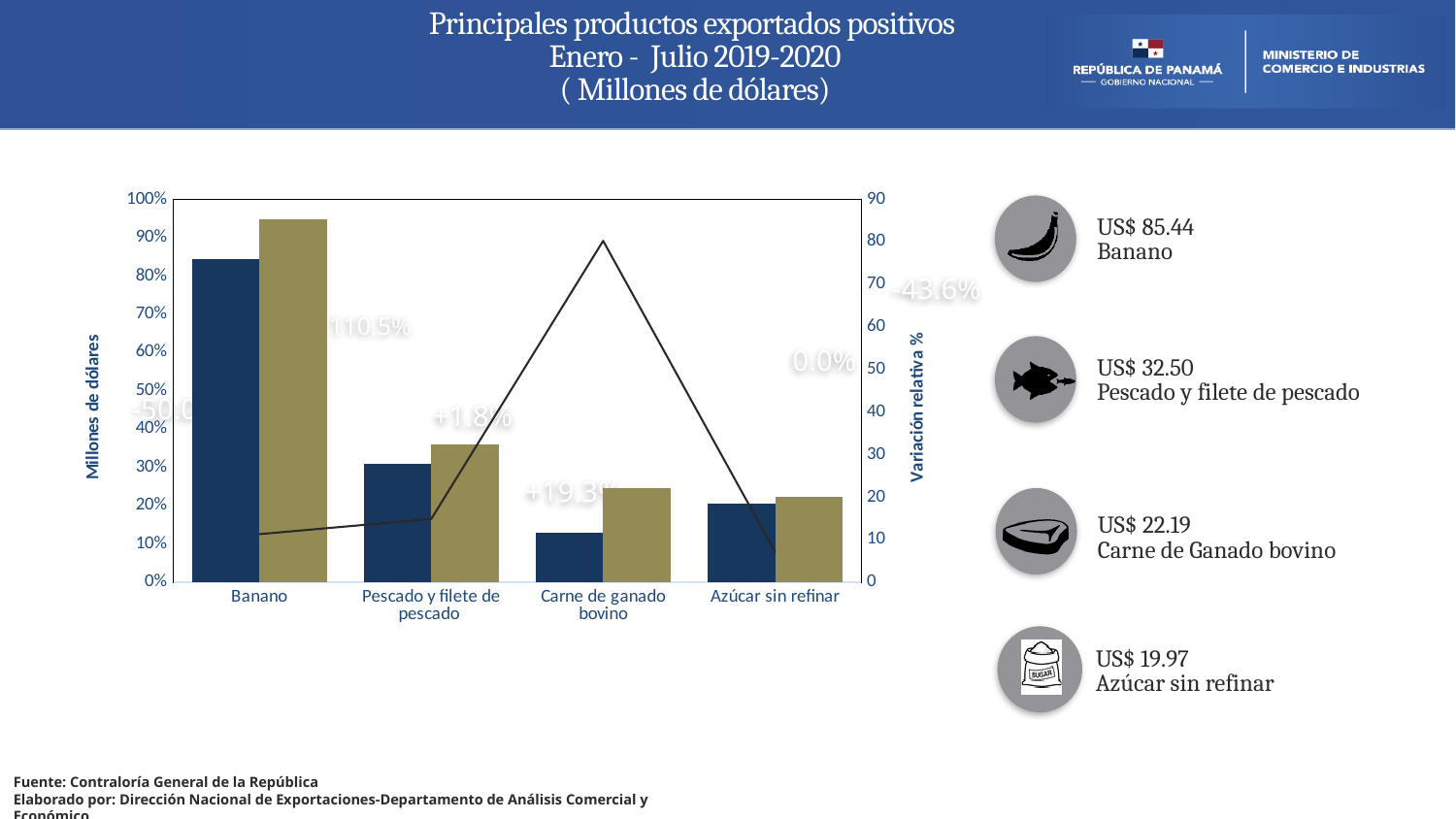
What is the title of the left-hand vertical axis of the chart? Millones de dólares How many product categories are shown on the x axis of the chart? 4 For Carne de ganado bovino, is the dark blue bar greater or less than 20% on the left axis? less For Banano, is the olive bar greater or less than 90% on the left axis? greater Which category has the tallest bars in the chart? Banano What kind of chart is shown on the slide? A bar chart combined with a line What is the title of the right-hand vertical axis of the chart? Variación relativa % At which category does the line in the chart reach its peak? Carne de ganado bovino Does the line rise or fall between Carne de ganado bovino and Azúcar sin refinar? Fall For Pescado y filete de pescado, is the dark blue bar greater or less than 40% on the left axis? less For Banano, which bar is taller, the dark blue one or the olive one? The olive one Which category has the shortest dark blue bar? Carne de ganado bovino